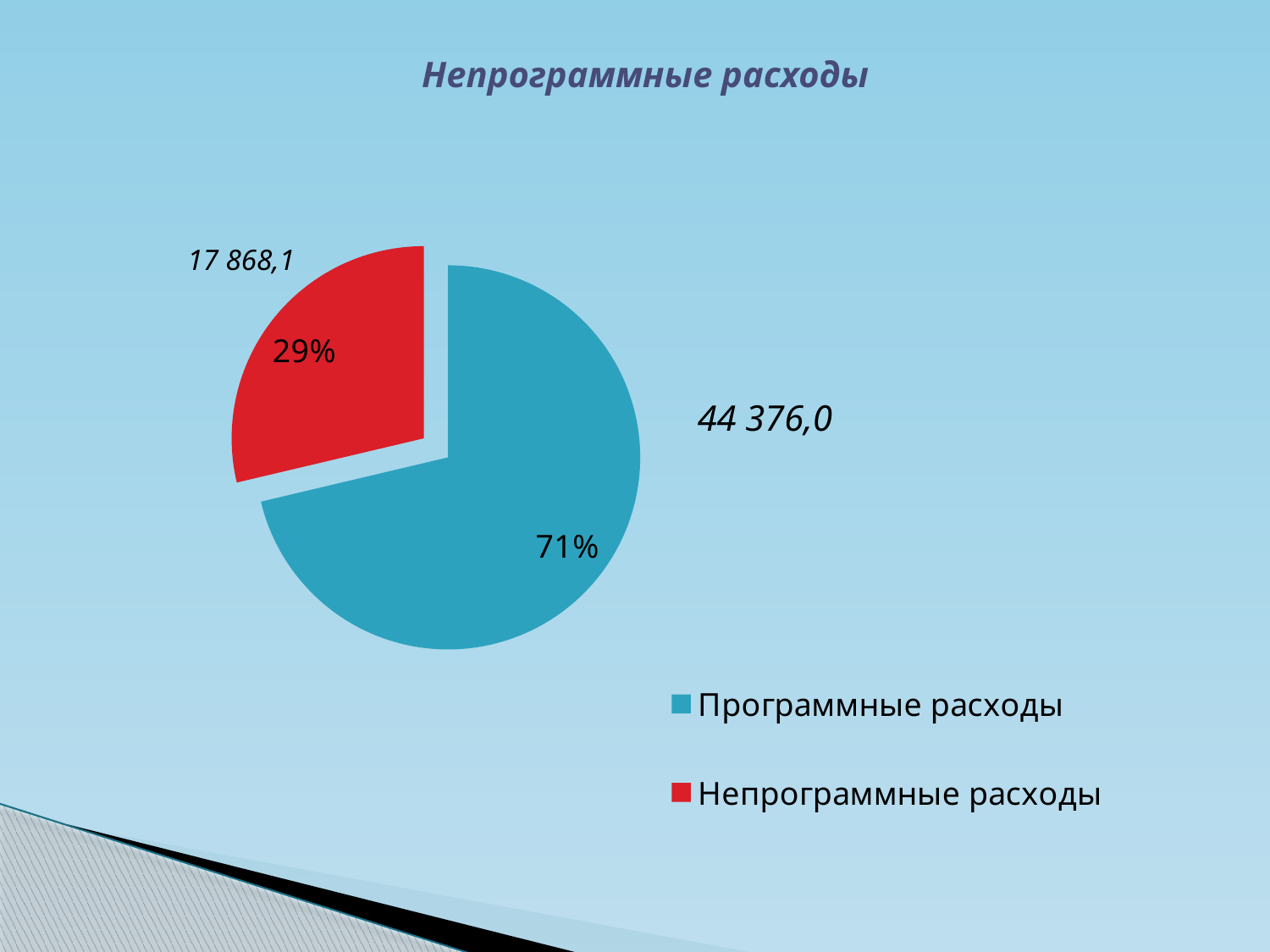
How many slices does the pie chart have? 2 What value is shown next to the Программные расходы slice? 44 376,0 What value is shown next to the Непрограммные расходы slice? 17 868,1 Which is larger, Программные расходы or Непрограммные расходы? Программные расходы What kind of chart is shown on the slide? pie chart What colour is the Непрограммные расходы slice? red What share of the pie does Непрограммные расходы take? 29% Which category has the largest slice of the pie? Программные расходы What share of the pie does Программные расходы take? 71% What is the difference in percentage points between the Программные расходы and Непрограммные расходы slices? 42 What is the title of the slide? Непрограммные расходы Which category has the smallest slice of the pie? Непрограммные расходы